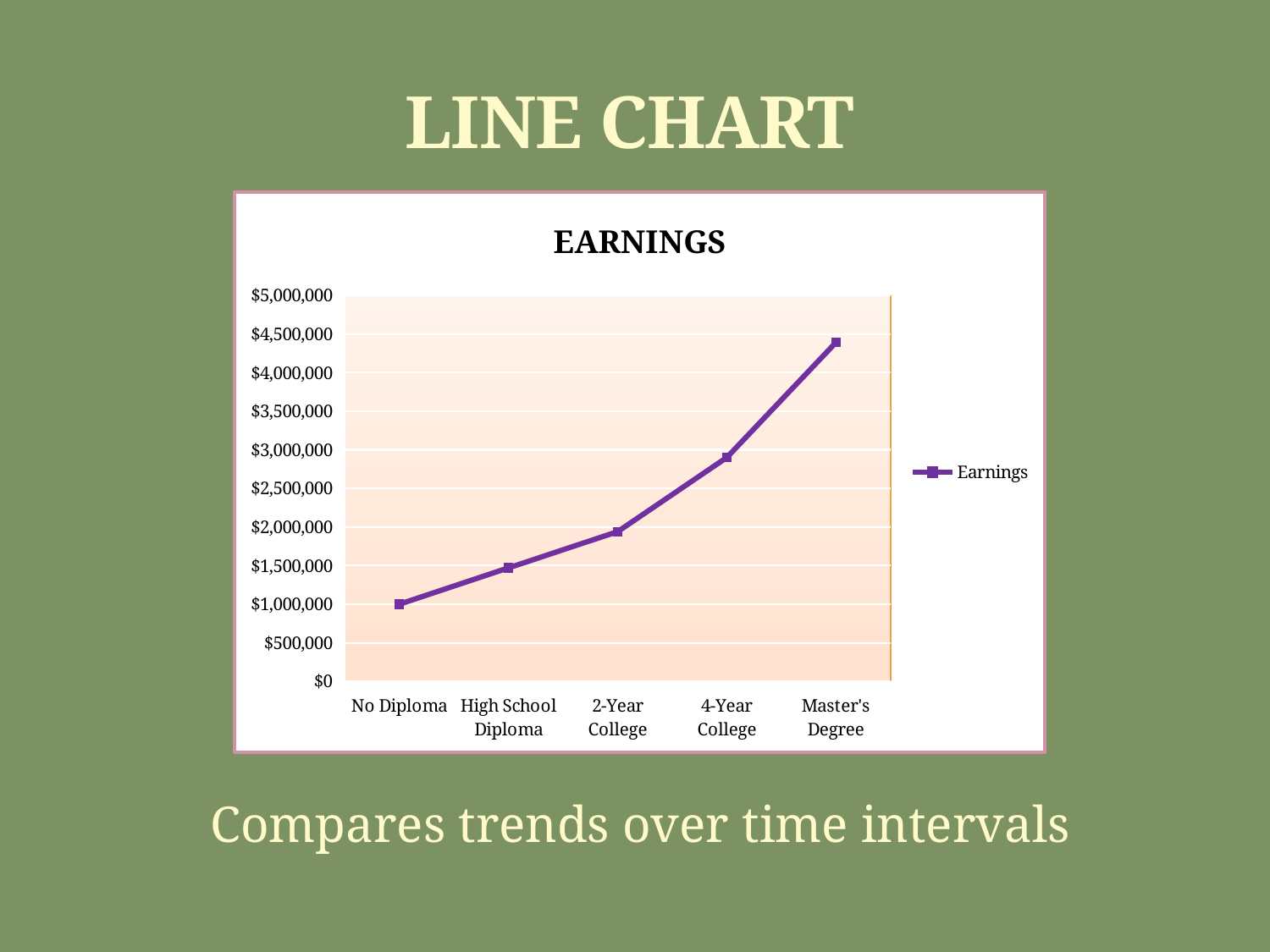
Is the value for 4-Year College greater or less than $3,000,000? less Which is larger, the value for 2-Year College or the value for 4-Year College? 4-Year College How many series does the legend list? 1 Do the earnings values rise or fall from No Diploma to Master's Degree? rise What is the title of the chart? EARNINGS Which category has the lowest earnings value? No Diploma What kind of chart is shown on the slide? line chart Is the value for Master's Degree greater or less than $4,000,000? greater Which category has the highest earnings value? Master's Degree What is the earnings value for No Diploma? $1,000,000 How many categories are plotted along the x axis? 5